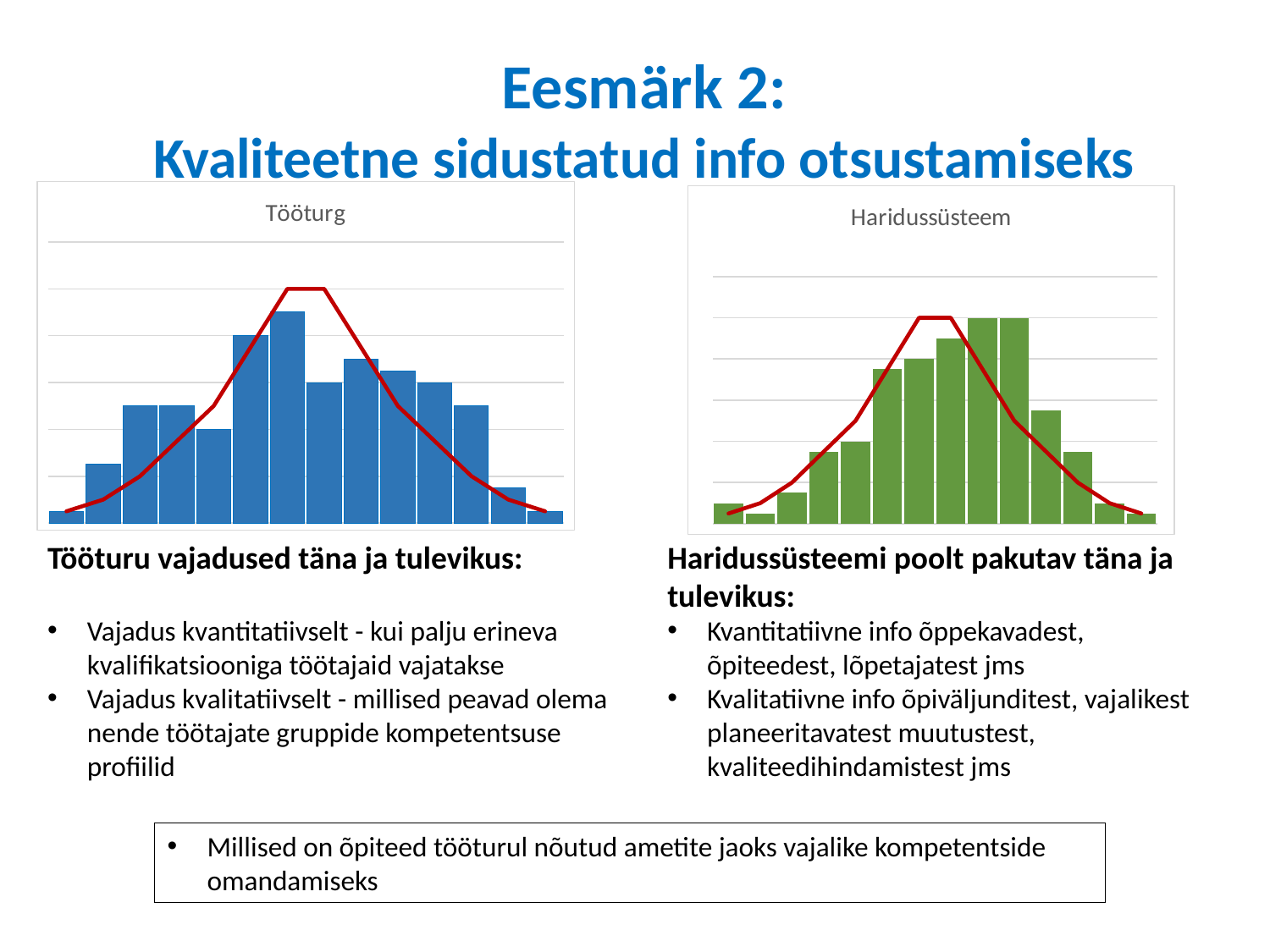
In the Tööturg chart, which is taller: the seventh bar from the left or the eighth bar from the left? the seventh bar In the Haridussüsteem chart, are the tallest bars in the left half or the right half of the chart? right half What is the title of the chart on the left side of the slide? Tööturg In the Haridussüsteem chart, do the bar values rise and then fall from left to right, or fall steadily? rise and then fall In the Tööturg chart, do the bar values rise and then fall from left to right, or rise steadily? rise and then fall How many bars does the Tööturg chart have? 14 What kind of chart is the Haridussüsteem chart on the right? combination bar and line chart What kind of chart is the Tööturg chart on the left? combination bar and line chart In the Haridussüsteem chart, which is taller: the fourth bar from the left or the fifth bar from the left? the fifth bar How many bars does the Haridussüsteem chart have? 14 In the Tööturg chart, is the tallest bar in the left half or the right half of the chart? left half What is the title of the chart on the right side of the slide? Haridussüsteem